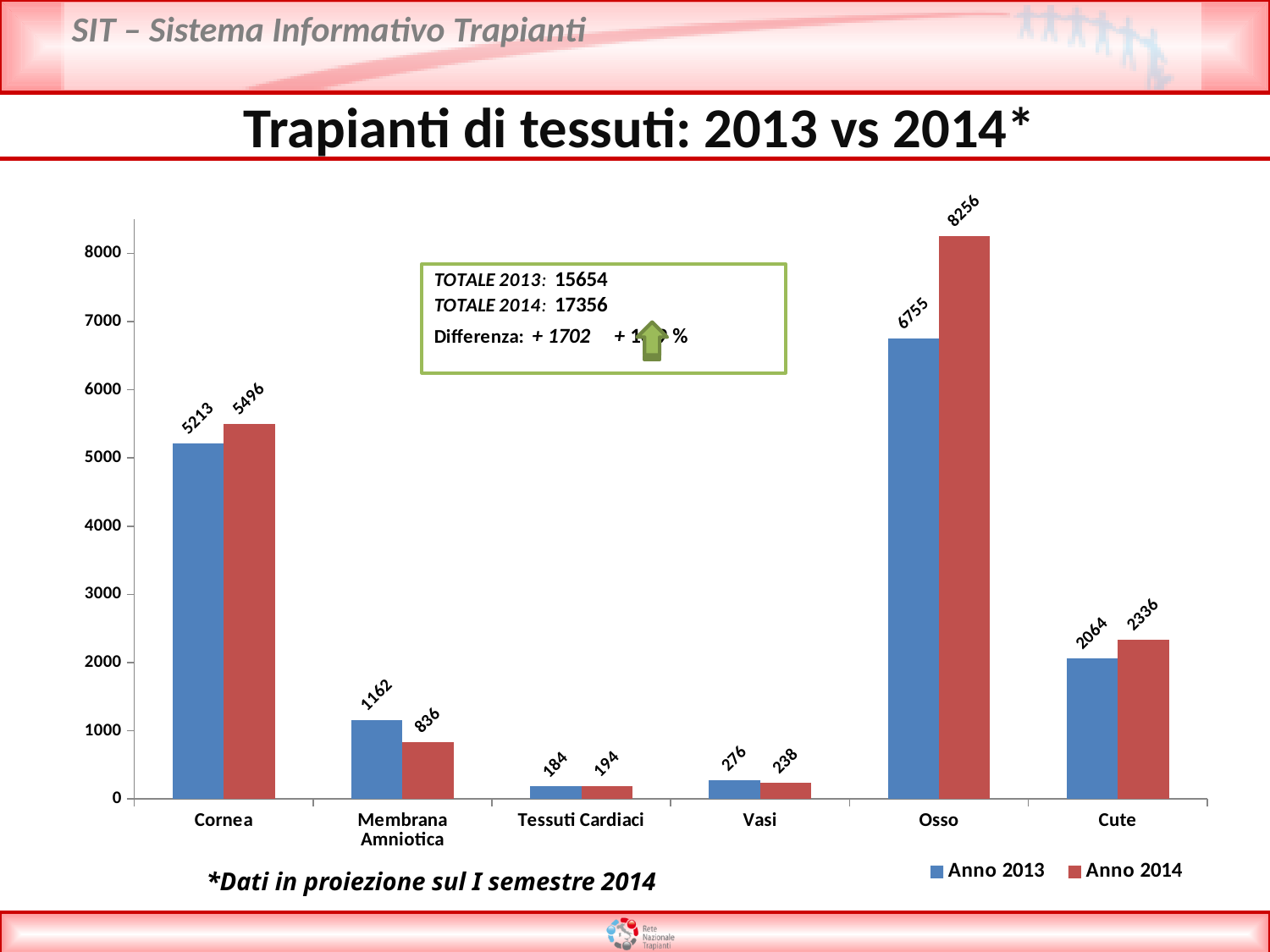
How many series does the legend list? 2 Which category has the highest value in the Anno 2014 series? Osso Which category has the lowest value in the Anno 2013 series? Tessuti Cardiaci What is the value for Cornea in the Anno 2014 series? 5496 Which is larger for Vasi: the Anno 2013 value or the Anno 2014 value? Anno 2013 What is the total for 2013 shown in the text box on the chart? 15654 What is the difference between the Anno 2014 and Anno 2013 values for Cute? 272 What colour are the Anno 2014 bars? Red How many categories are shown on the x axis? 6 What kind of chart is shown on the slide? Bar chart What is the value for Membrana Amniotica in the Anno 2014 series? 836 What is the value for Osso in the Anno 2013 series? 6755